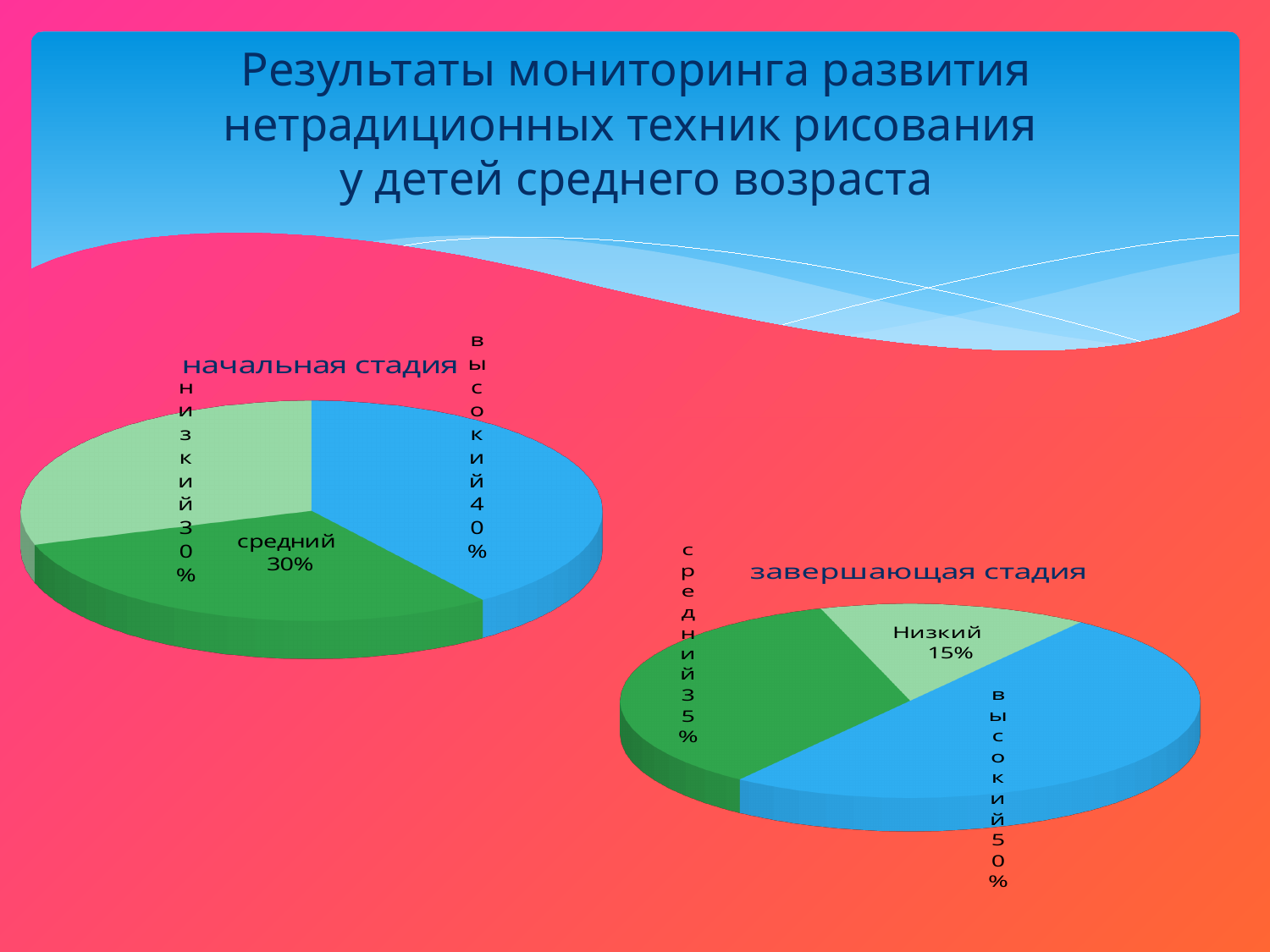
In the chart titled "завершающая стадия", what is the difference between "высокий" and "Низкий"? 35% In the chart titled "завершающая стадия", what is the value for "средний"? 35% Which is larger: "высокий" in the "начальная стадия" chart or "высокий" in the "завершающая стадия" chart? завершающая стадия In the chart titled "начальная стадия", what is the value for "средний"? 30% In the chart titled "завершающая стадия", which category has the smallest share? Низкий In the chart titled "завершающая стадия", what is the value for "Низкий"? 15% What type of chart is the chart titled "завершающая стадия"? Pie chart How many charts are shown on the slide? 2 In the chart titled "завершающая стадия", which category has the largest share? высокий In the chart titled "начальная стадия", what is the value for "высокий"? 40% In the chart titled "начальная стадия", which category has the largest share? высокий How many slices does the chart titled "начальная стадия" have? 3